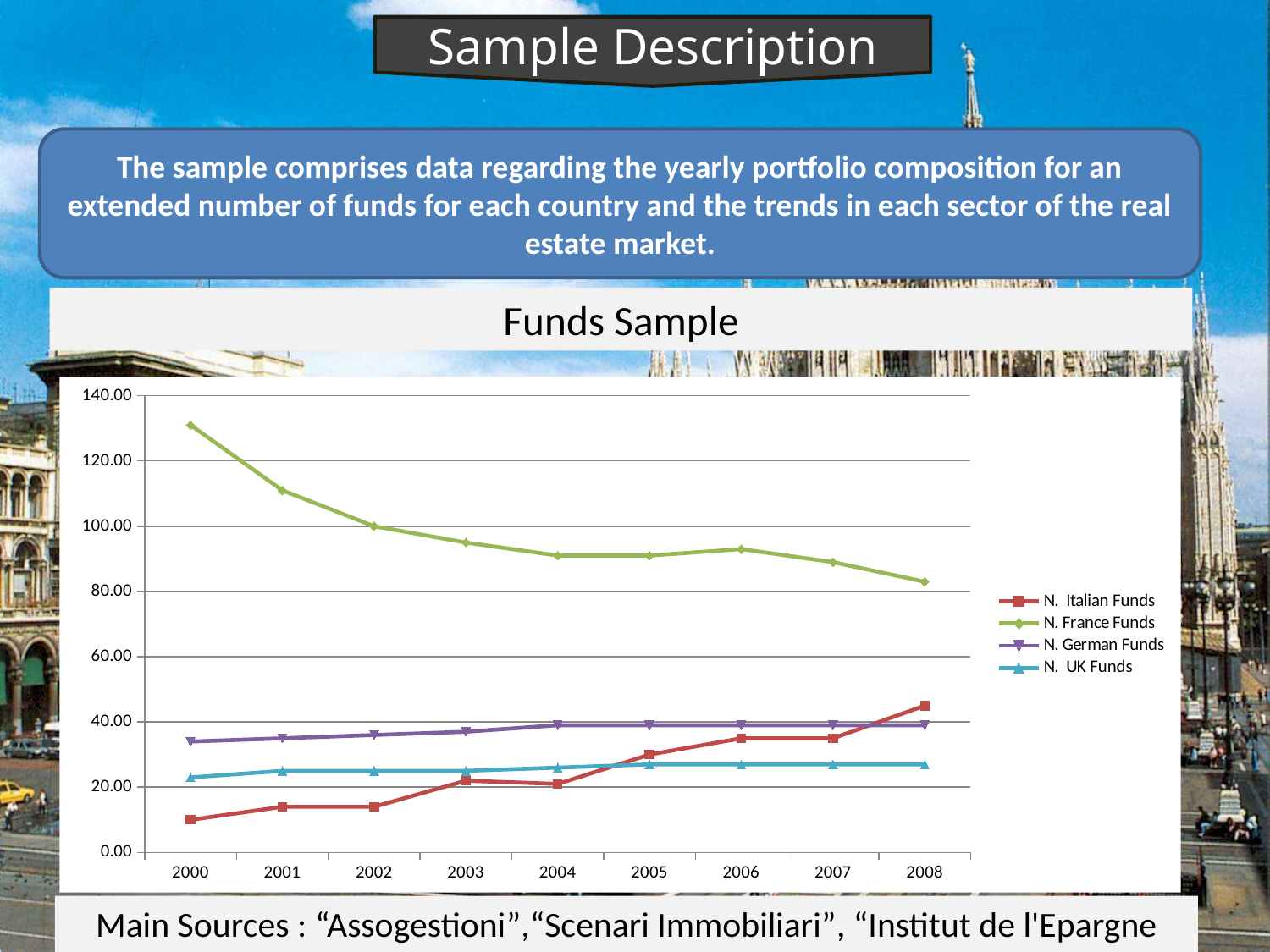
Is the value for N. UK Funds in 2008 greater or less than 20.00? greater Does the N. France Funds line rise or fall from 2000 to 2008? fall Is the value for N. Italian Funds in 2000 greater or less than 20.00? less In 2008, which is larger: N. Italian Funds or N. German Funds? N. Italian Funds Which series has the highest value in 2000? N. France Funds Is the value for N. German Funds in 2000 greater or less than 40.00? less Which series has the lowest value in 2000? N. Italian Funds How many years are shown on the x axis of the Funds Sample chart? 9 What kind of chart is the Funds Sample chart? line chart How many series does the legend of the Funds Sample chart list? 4 Does the N. Italian Funds line rise or fall from 2000 to 2008? rise